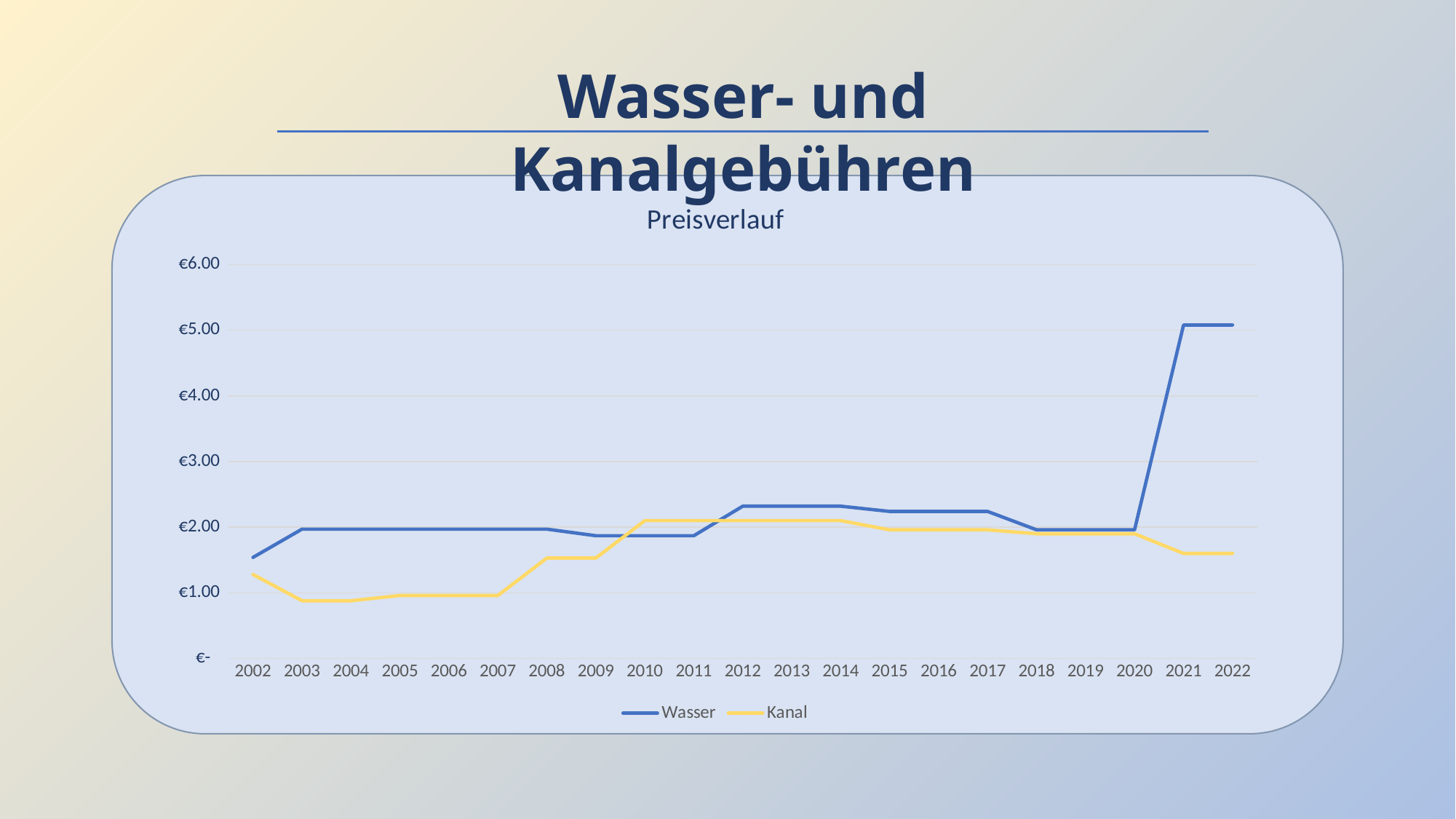
In 2010, which series has the higher value, Wasser or Kanal? Kanal Is the value for Kanal in 2022 greater or less than €2.00? less How many years are shown on the x axis of the Preisverlauf chart? 21 What kind of chart is shown on the slide? line chart Is the value for Wasser in 2002 greater or less than €2.00? less In 2022, which series has the higher value, Wasser or Kanal? Wasser Is the value for Kanal in 2003 greater or less than €1.00? less How many series does the legend of the Preisverlauf chart list? 2 Which colour is used for the Kanal series in the chart? yellow Does the Kanal line rise or fall from 2020 to 2021? fall Does the Wasser line rise or fall from 2020 to 2021? rise